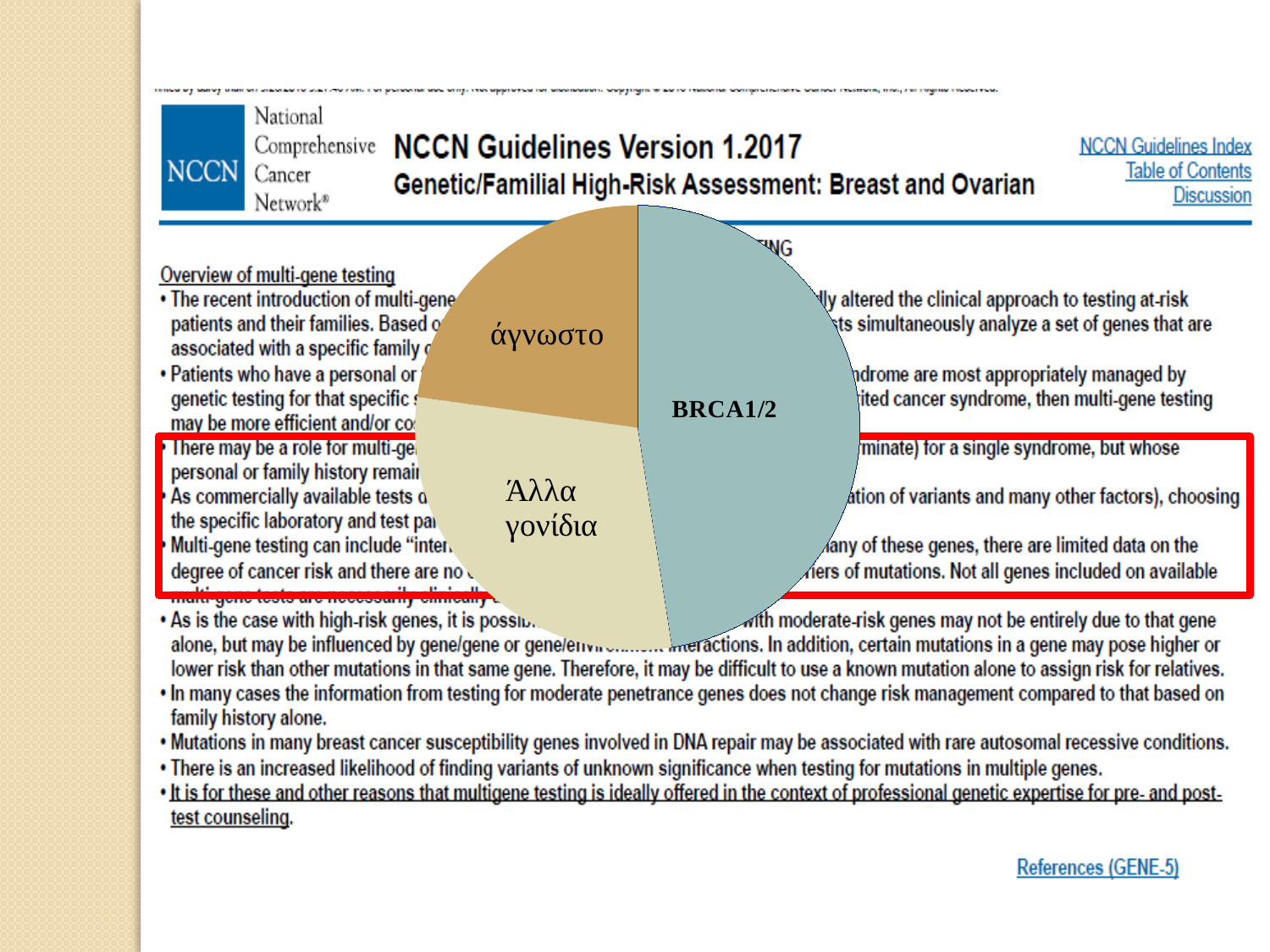
Which slice of the pie chart is the largest? BRCA1/2 Which slice is larger, BRCA1/2 or Άλλα γονίδια? BRCA1/2 What are the labels of the three slices in the pie chart? άγνωστο, BRCA1/2, Άλλα γονίδια How many slices does the pie chart have? 3 What kind of chart is shown on the slide? pie chart Which slice is larger, BRCA1/2 or άγνωστο? BRCA1/2 What colour is the BRCA1/2 slice of the pie chart? blue-grey